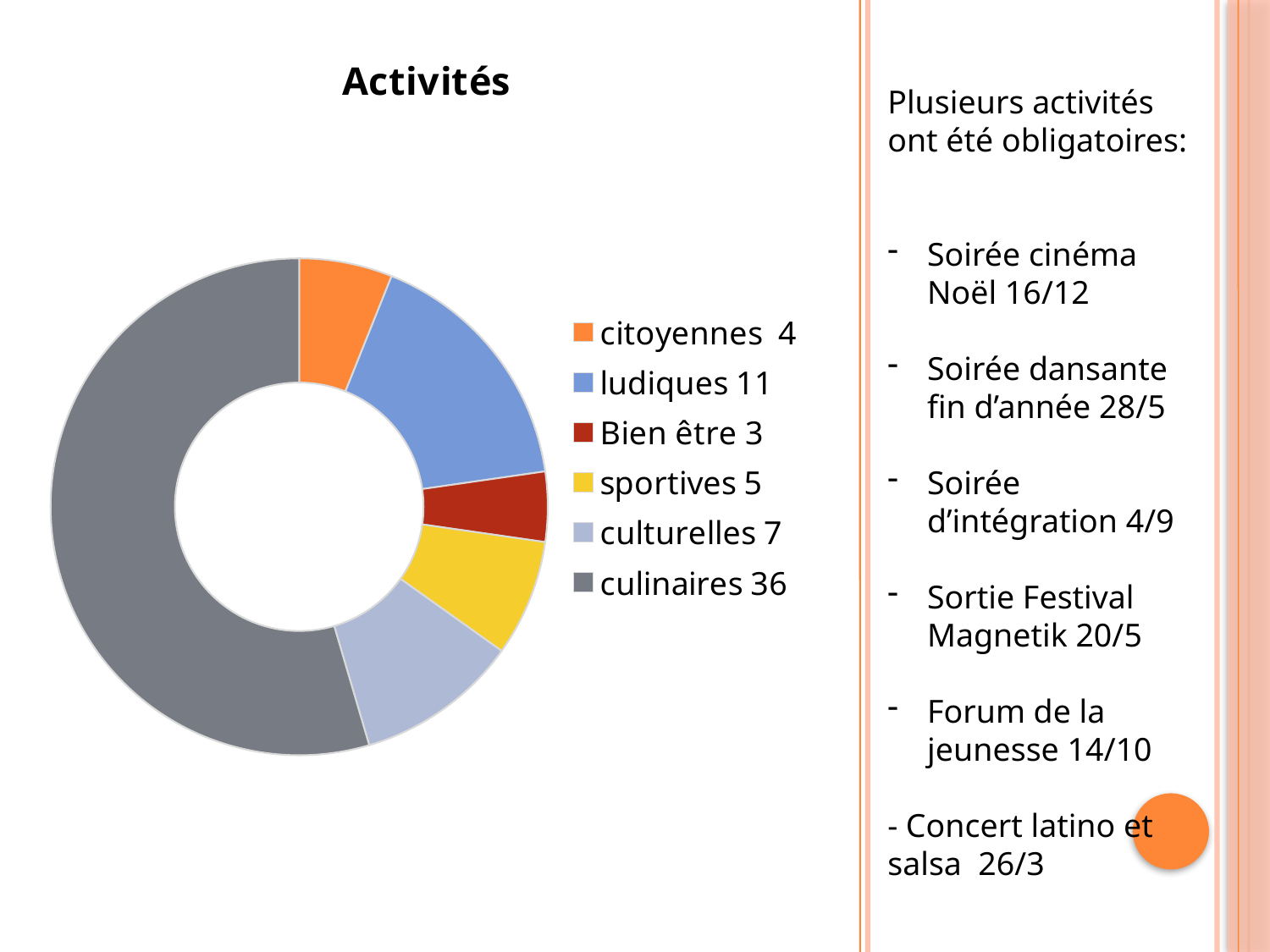
What is the value for culinaires? 36 What is the title of the chart? Activités How many categories does the chart show? 6 Which colour represents citoyennes in the chart? Orange What is the value for ludiques? 11 What is the total of all the values shown in the chart? 66 What kind of chart is shown on the slide? Doughnut (pie) chart What is the difference between the values for culinaires and ludiques? 25 Which category has the highest value? culinaires Which is larger, culturelles or sportives? culturelles Which category has the lowest value? Bien être What is the value for Bien être? 3